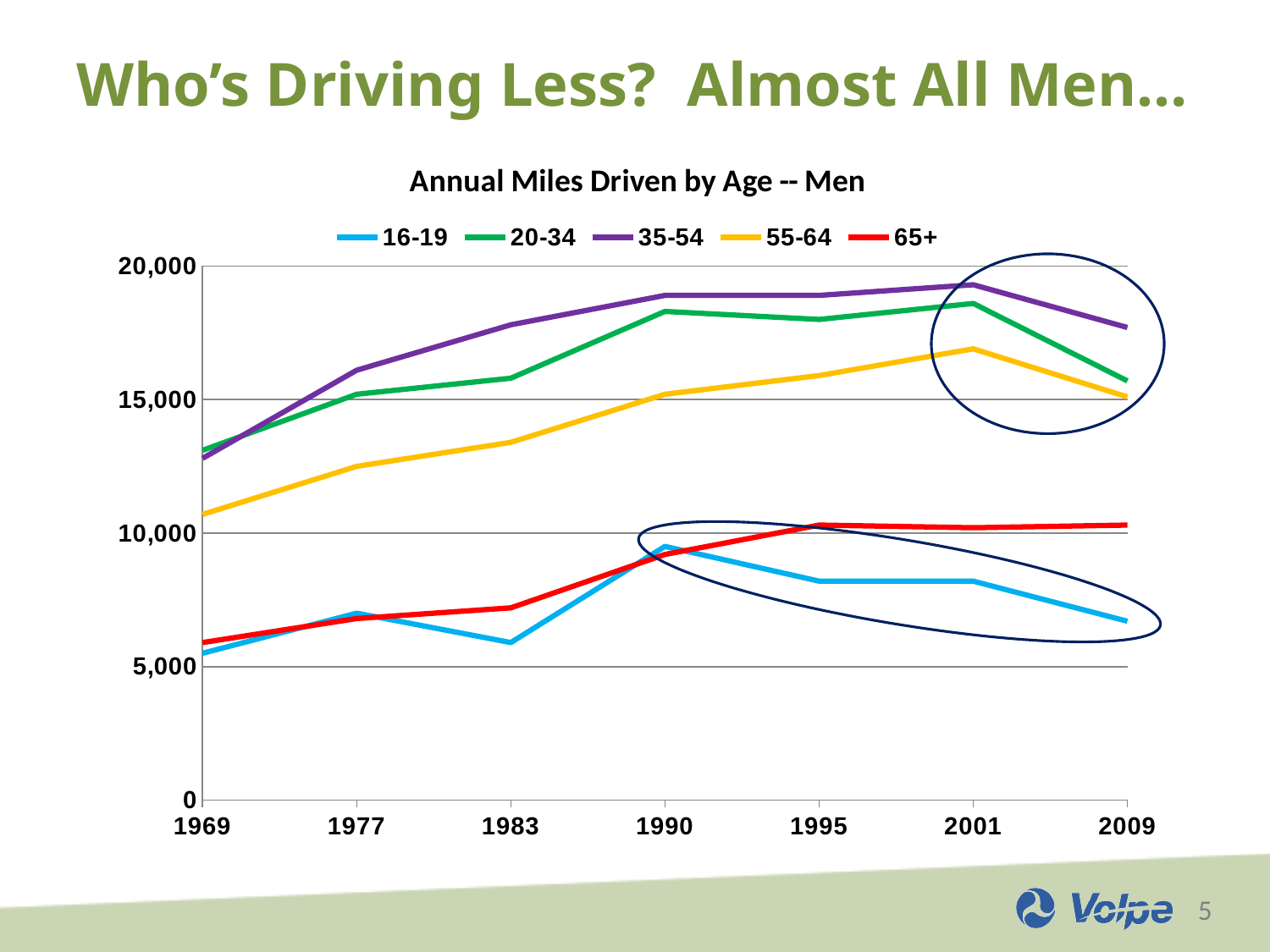
Is the value for the 20-34 group in 1990 greater or less than 15,000? greater In 2009, which group drove more miles: 65+ or 16-19? 65+ How many years are shown on the x axis? 7 What kind of chart is shown on the slide? line chart Do the annual miles for the 16-19 group rise or fall from 1990 to 2009? fall In 1977, which group drove more miles: 55-64 or 16-19? 55-64 Is the value for the 16-19 group in 2009 greater or less than 10,000? less Which age group has the highest annual miles driven in 2009? 35-54 How many series does the legend list? 5 What is the title of the chart? Annual Miles Driven by Age -- Men Which age group has the lowest annual miles driven in 2009? 16-19 Is the value for the 35-54 group in 2001 greater or less than 15,000? greater